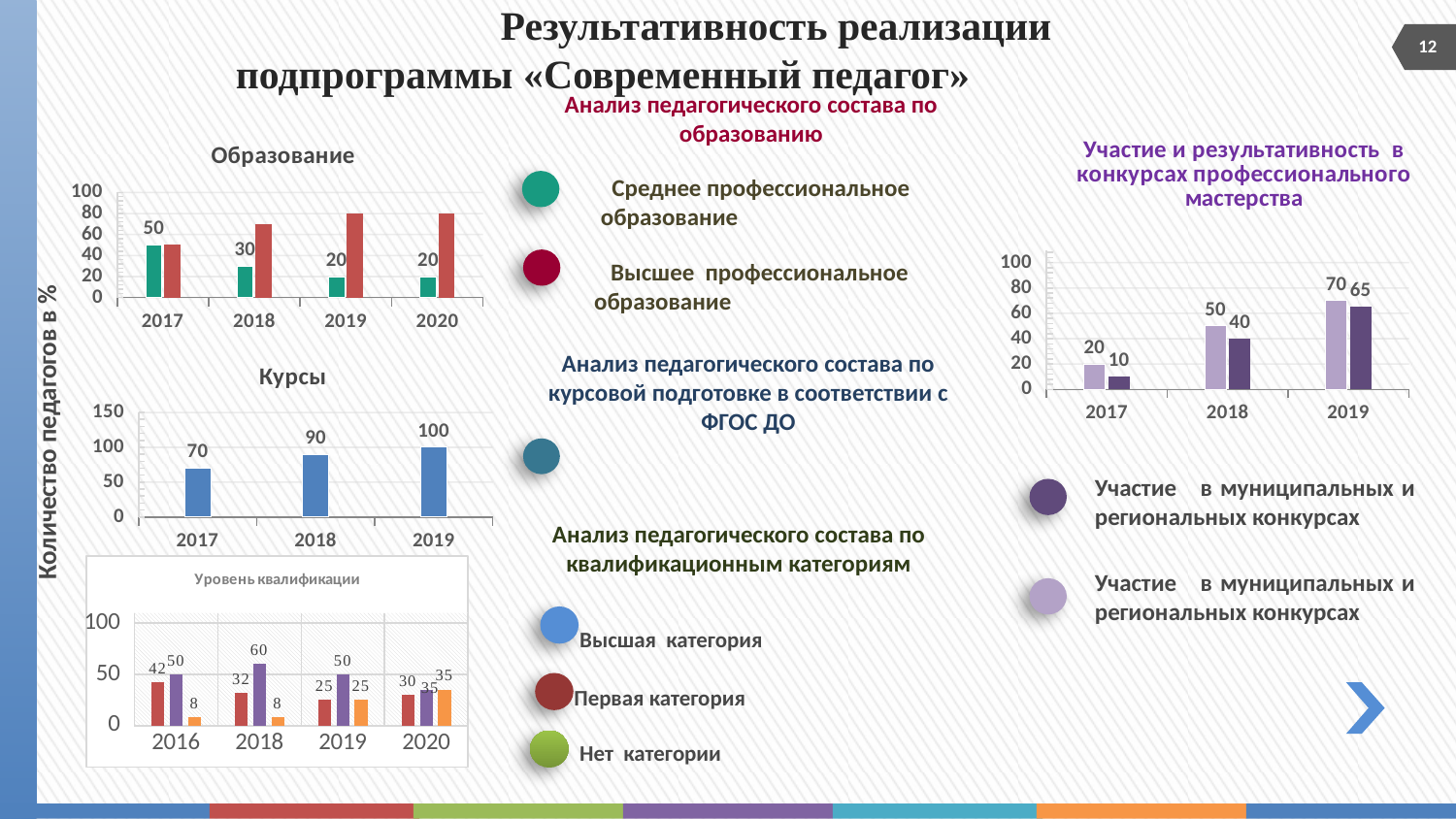
In the 'Участие и результативность в конкурсах профессионального мастерства' chart, what is the value of the light purple bar for 2019? 70 In the 'Образование' chart, is the red bar for 2019 greater or less than 60? greater In the 'Образование' chart, what is the value of the teal bar for 2018? 30 In the 'Курсы' chart, what is the difference between the 2019 and 2017 values? 30 In the 'Курсы' chart, what is the value for 2017? 70 In the 'Участие и результативность в конкурсах профессионального мастерства' chart, what is the difference between the two bars for 2018? 10 In the 'Уровень квалификации' chart, what is the highest value shown for 2018? 60 In the 'Курсы' chart, what is the value for 2019? 100 What type of chart is the 'Курсы' chart? bar chart In the 'Курсы' chart, do the values rise or fall from 2017 to 2019? rise In the 'Образование' chart, how many years are shown on the x axis? 4 In the 'Курсы' chart, which year has the lowest value? 2017